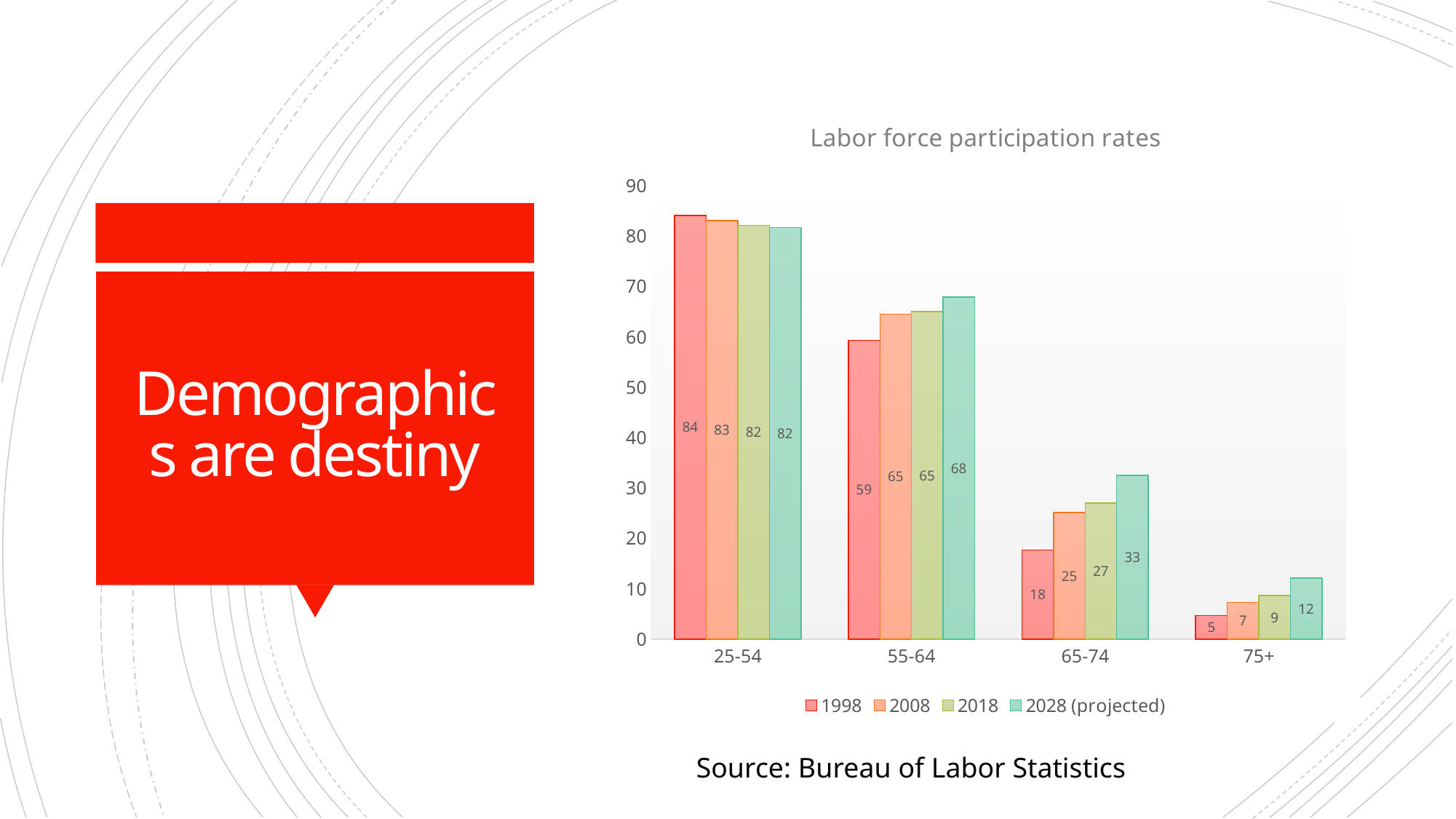
What is the labor force participation rate for the 25-54 age group in 1998? 84 What kind of chart is shown on the slide? Bar chart Do the 2028 (projected) values rise or fall as you move from the 25-54 group to the 75+ group? Fall What is the 2028 (projected) value for the 65-74 age group? 33 Which age group has the lowest 1998 value? 75+ What is the difference between the 2028 (projected) and 1998 values for the 55-64 age group? 9 How many age groups are shown on the x axis? 4 How many series does the legend list? 4 What is the 2008 value for the 75+ age group? 7 Which is larger for the 65-74 age group: the 2008 value or the 2018 value? 2018 What is the title of the chart? Labor force participation rates Which age group has the highest 2018 value? 25-54